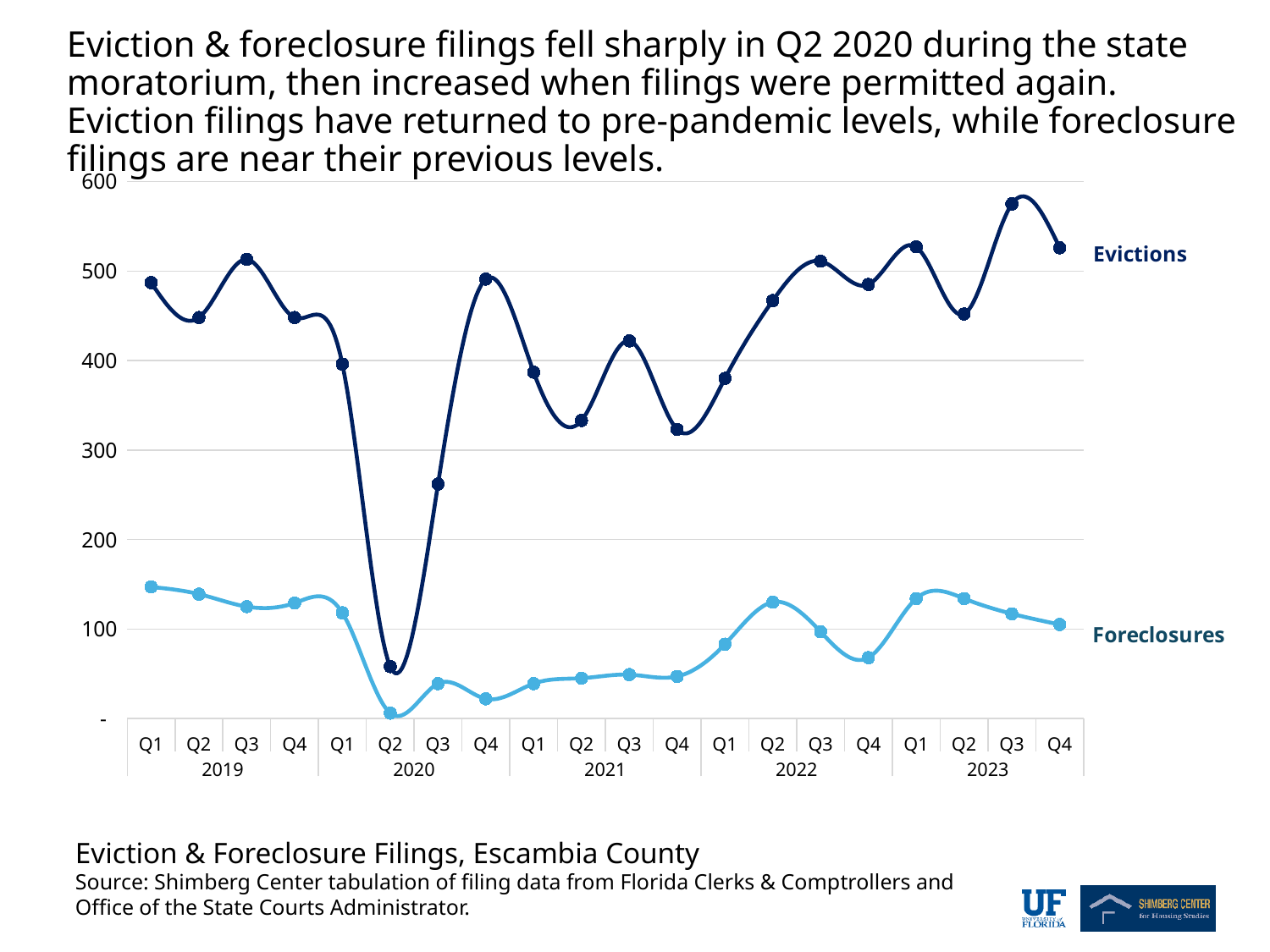
What is the title of the chart shown at the bottom of the slide? Eviction & Foreclosure Filings, Escambia County What are the names of the two series plotted on the chart? Evictions and Foreclosures How many quarterly data points does each series have? 20 Is the value for Evictions in Q2 2020 greater or less than 100? less Is the value for Evictions in Q3 2023 greater or less than 500? greater Which series has the higher value in Q4 2023, Evictions or Foreclosures? Evictions How many series are plotted on the chart? 2 In which quarter does the Foreclosures series reach its lowest value? Q2 2020 In which quarter does the Evictions series reach its highest value? Q3 2023 In which quarter does the Evictions series reach its lowest value? Q2 2020 What kind of chart is shown on the slide? line chart Is the value for Foreclosures in Q1 2019 greater or less than 100? greater